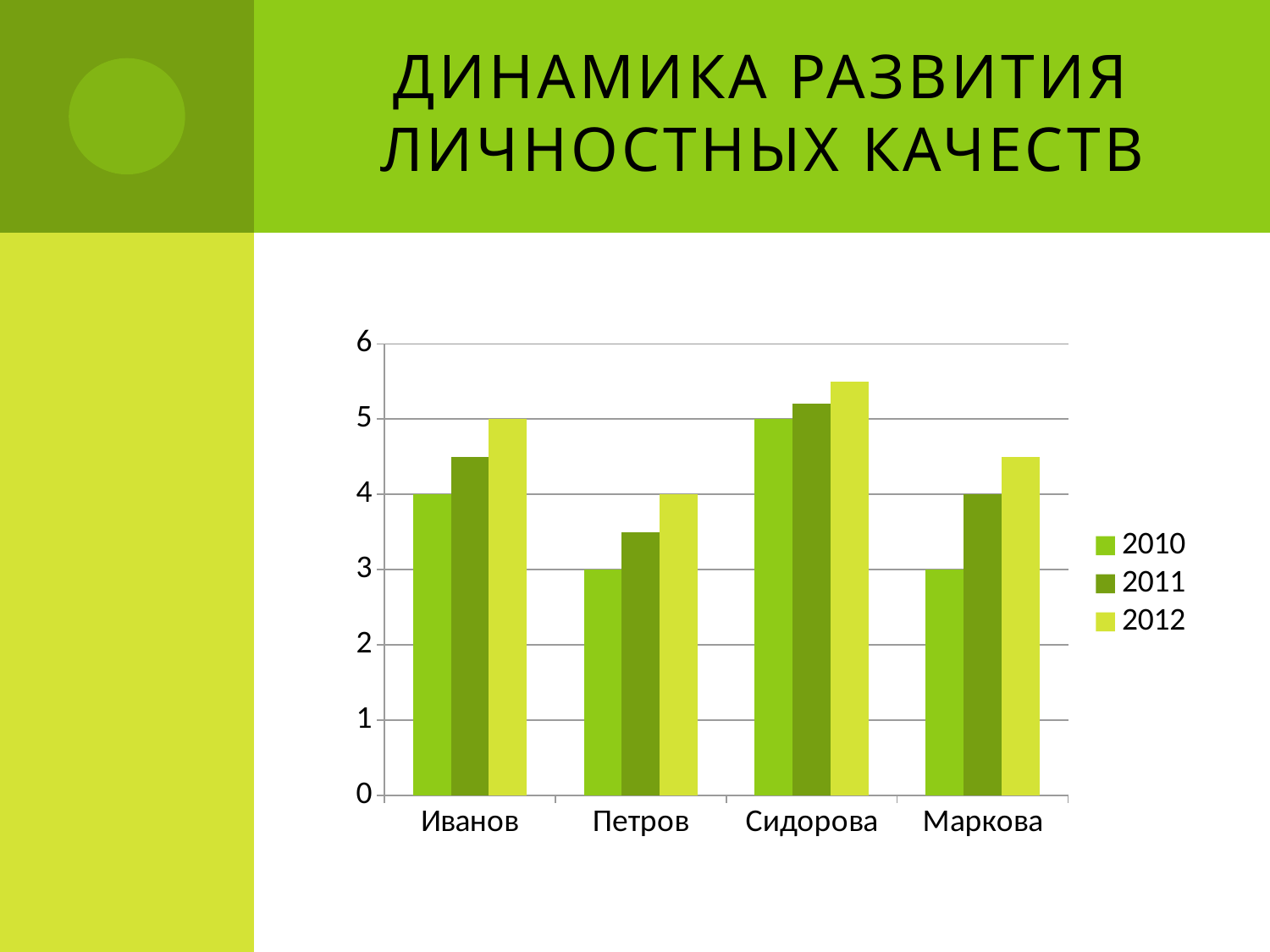
What is the value for Иванов in 2012? 5 Is the value for Петров in 2011 greater or less than 4? less How many categories are shown on the x axis? 4 Which category has the highest value in 2012? Сидорова What is the value for Иванов in 2010? 4 Do the values for Иванов rise or fall from 2010 to 2012? rise How many series does the legend list? 3 What is the value for Петров in 2010? 3 Which category has the lowest value in 2011? Петров What is the value for Маркова in 2011? 4 What kind of chart is shown on the slide? bar chart Is the value for Сидорова in 2012 greater or less than 5? greater